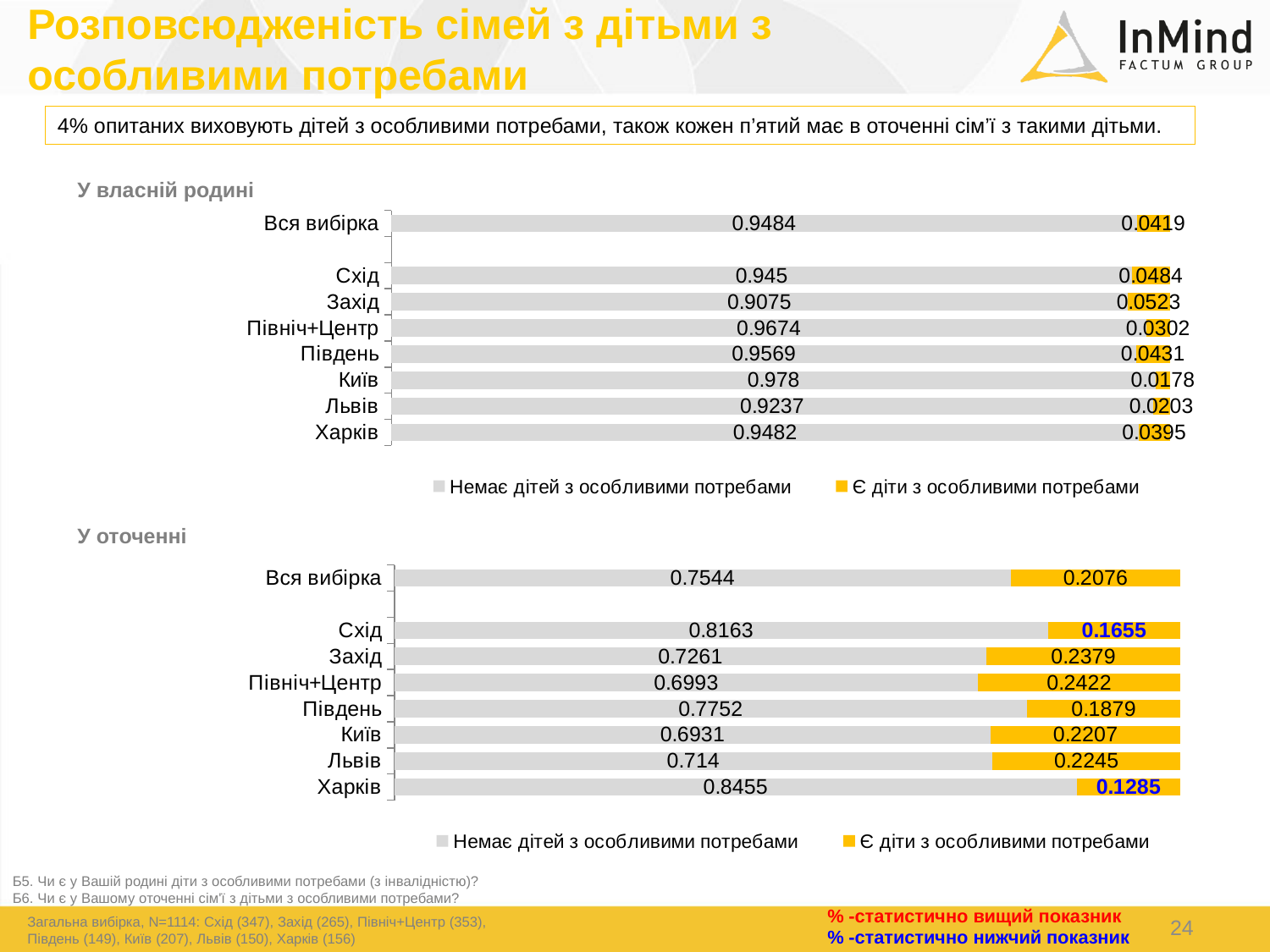
In the chart 'У оточенні', what is the value for 'Є діти з особливими потребами' for Харків? 0.1285 What type of chart is 'У оточенні'? Stacked bar chart In the chart 'У власній родині', which category has the lowest value for 'Є діти з особливими потребами'? Київ In the chart 'У власній родині', what is the value for 'Немає дітей з особливими потребами' for Київ? 0.978 In the chart 'У оточенні', which category has the highest value for 'Немає дітей з особливими потребами'? Харків In the chart 'У оточенні', what is the value for 'Немає дітей з особливими потребами' for Північ+Центр? 0.6993 In the chart 'У оточенні', what is the difference between the 'Є діти з особливими потребами' values for Північ+Центр and Схід? 0.0767 In the chart 'У власній родині', what is the value for 'Є діти з особливими потребами' for Захід? 0.0523 How many categories are shown in the chart 'У власній родині'? 8 How many series does the legend of the chart 'У оточенні' list? 2 In the chart 'У оточенні', which is larger for 'Є діти з особливими потребами': Львів or Південь? Львів In the chart 'У власній родині', which category has the highest value for 'Є діти з особливими потребами'? Захід